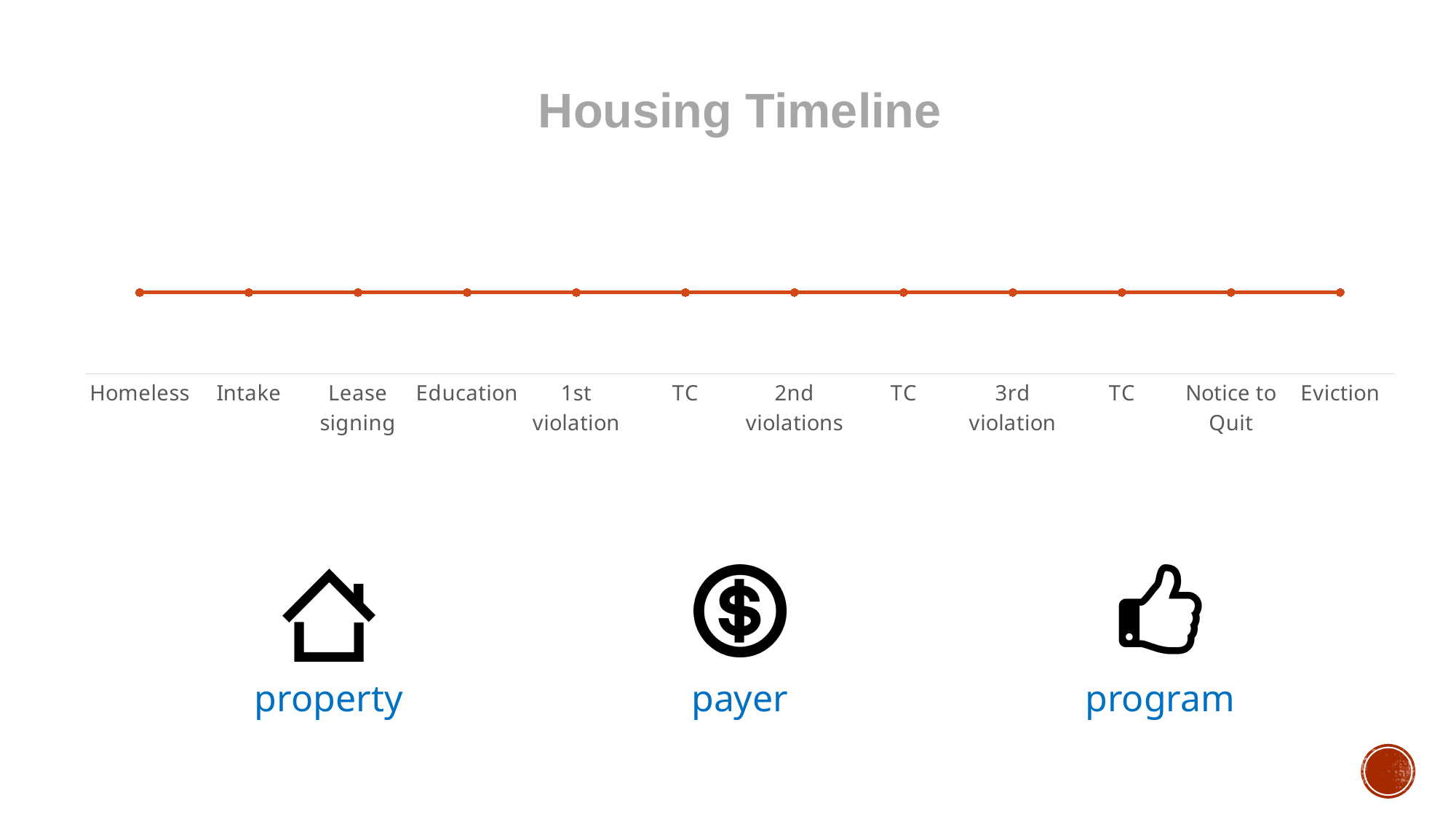
What kind of chart is shown on the slide? line chart How many points are plotted along the line? 12 How many times does the label "TC" appear on the x axis? 3 Do the plotted values rise, fall, or stay flat from left to right along the x axis? stay flat What is the last category on the x axis? Eviction How many categories are labelled on the x axis? 12 Which category comes immediately after "Lease signing" on the x axis? Education What is the title of the chart? Housing Timeline